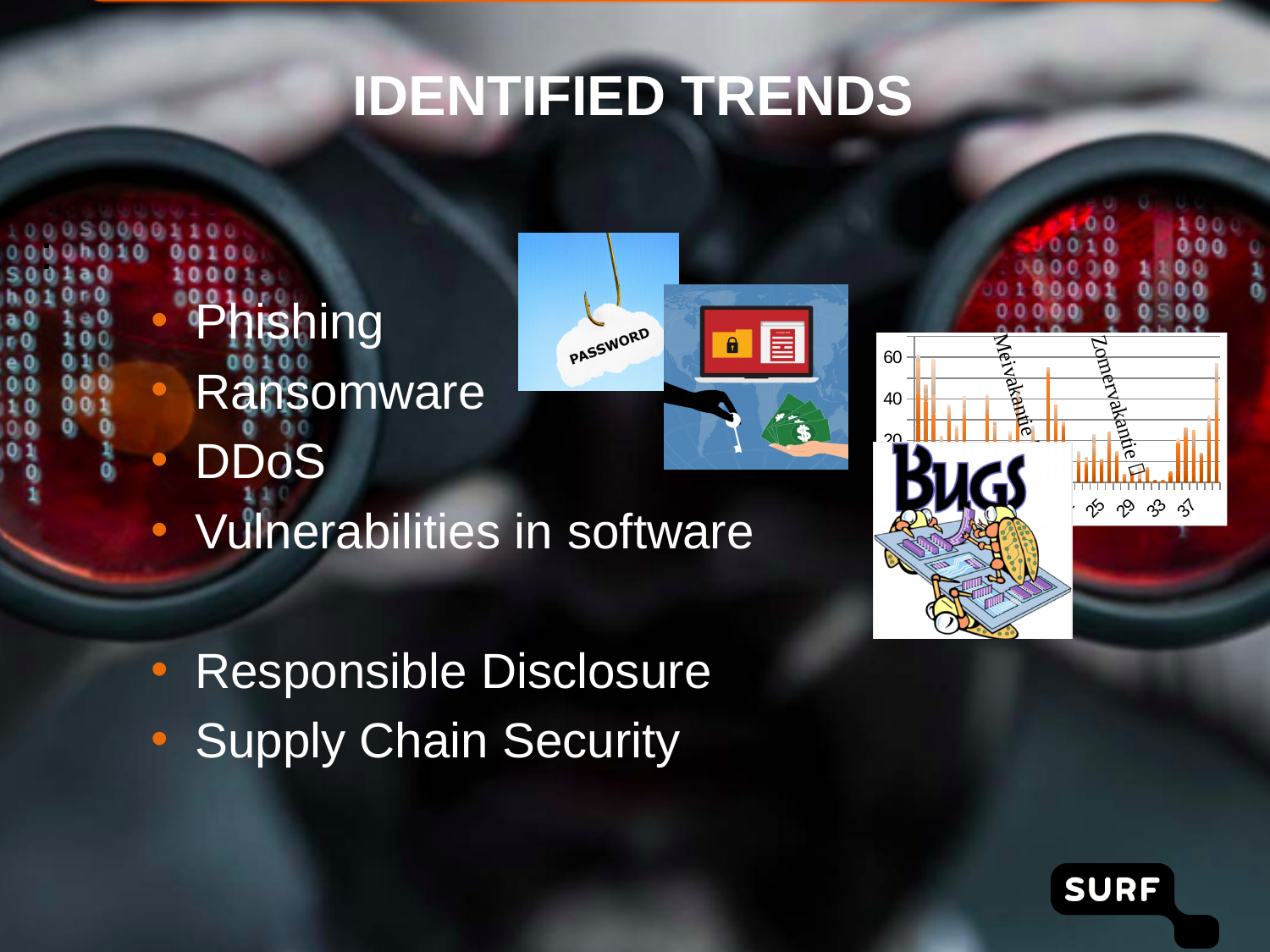
Is the tallest bar at the right end of the chart (near x-axis label 37) greater or less than 40? greater What kind of chart is shown on the right side of the slide? bar chart What two annotation labels are written on the chart? Meivakantie and Zomervakantie Is the bar at x-axis label 33 greater or less than 20? less What is the highest value labelled on the y axis of the chart? 60